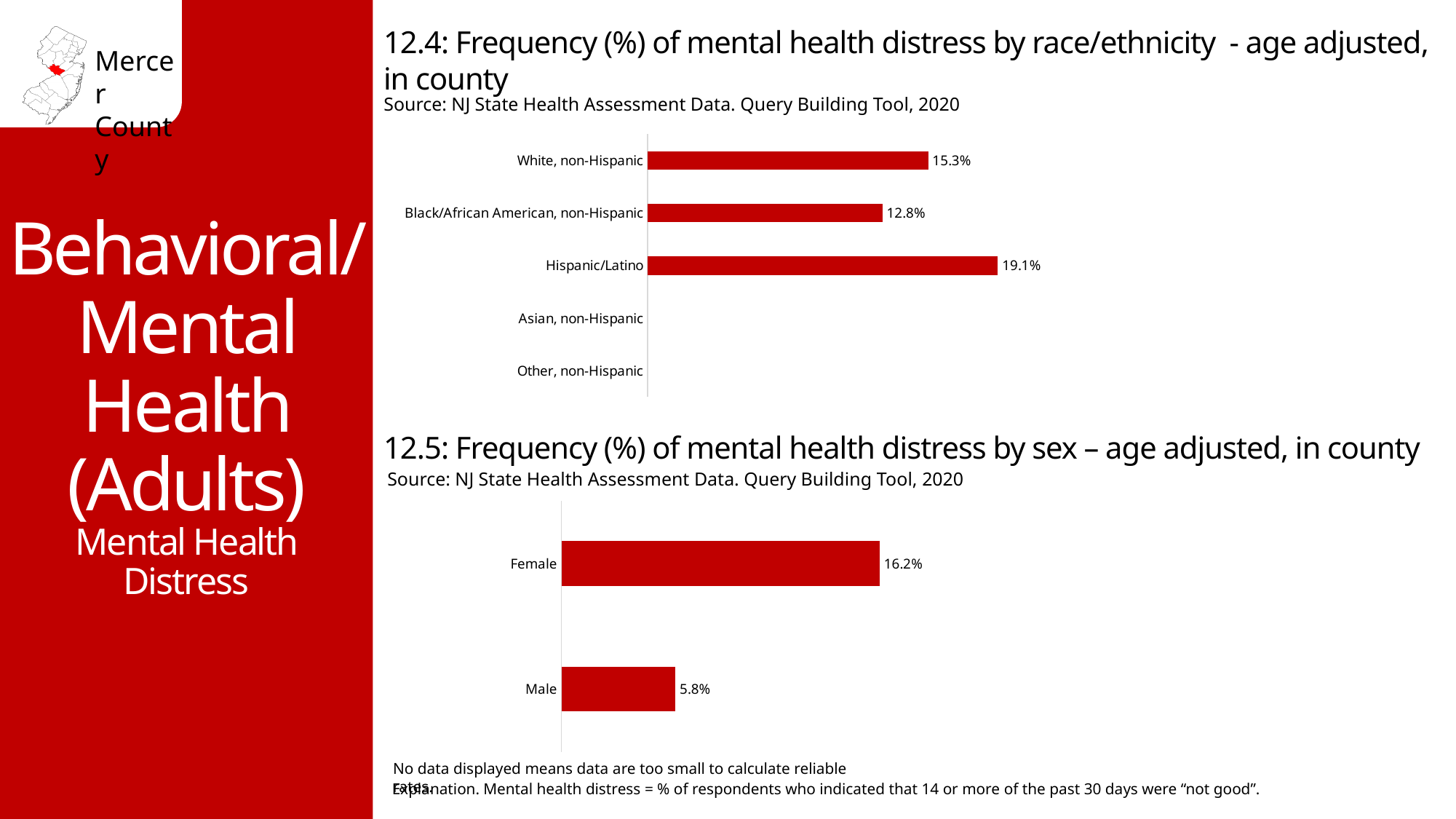
In the chart 12.4 (mental health distress by race/ethnicity), what is the value for White, non-Hispanic? 15.3% In the chart 12.5 (mental health distress by sex), what is the difference between the Female and Male values? 10.4% In the chart 12.5 (mental health distress by sex), what is the value for Male? 5.8% In the chart 12.4 (mental health distress by race/ethnicity), how many race/ethnicity categories are listed on the axis? 5 In the chart 12.4 (mental health distress by race/ethnicity), which categories have no bar displayed? Asian, non-Hispanic and Other, non-Hispanic In the chart 12.4 (mental health distress by race/ethnicity), which race/ethnicity group has the highest value? Hispanic/Latino In the chart 12.4 (mental health distress by race/ethnicity), what is the value for Black/African American, non-Hispanic? 12.8% In the chart 12.5 (mental health distress by sex), what is the value for Female? 16.2% In the chart 12.4 (mental health distress by race/ethnicity), what is the difference between the Hispanic/Latino and Black/African American, non-Hispanic values? 6.3% In the chart 12.5 (mental health distress by sex), which sex has the higher value, Female or Male? Female In the chart 12.4 (mental health distress by race/ethnicity), what is the value for Hispanic/Latino? 19.1% What type of chart is chart 12.5 (mental health distress by sex)? Bar chart